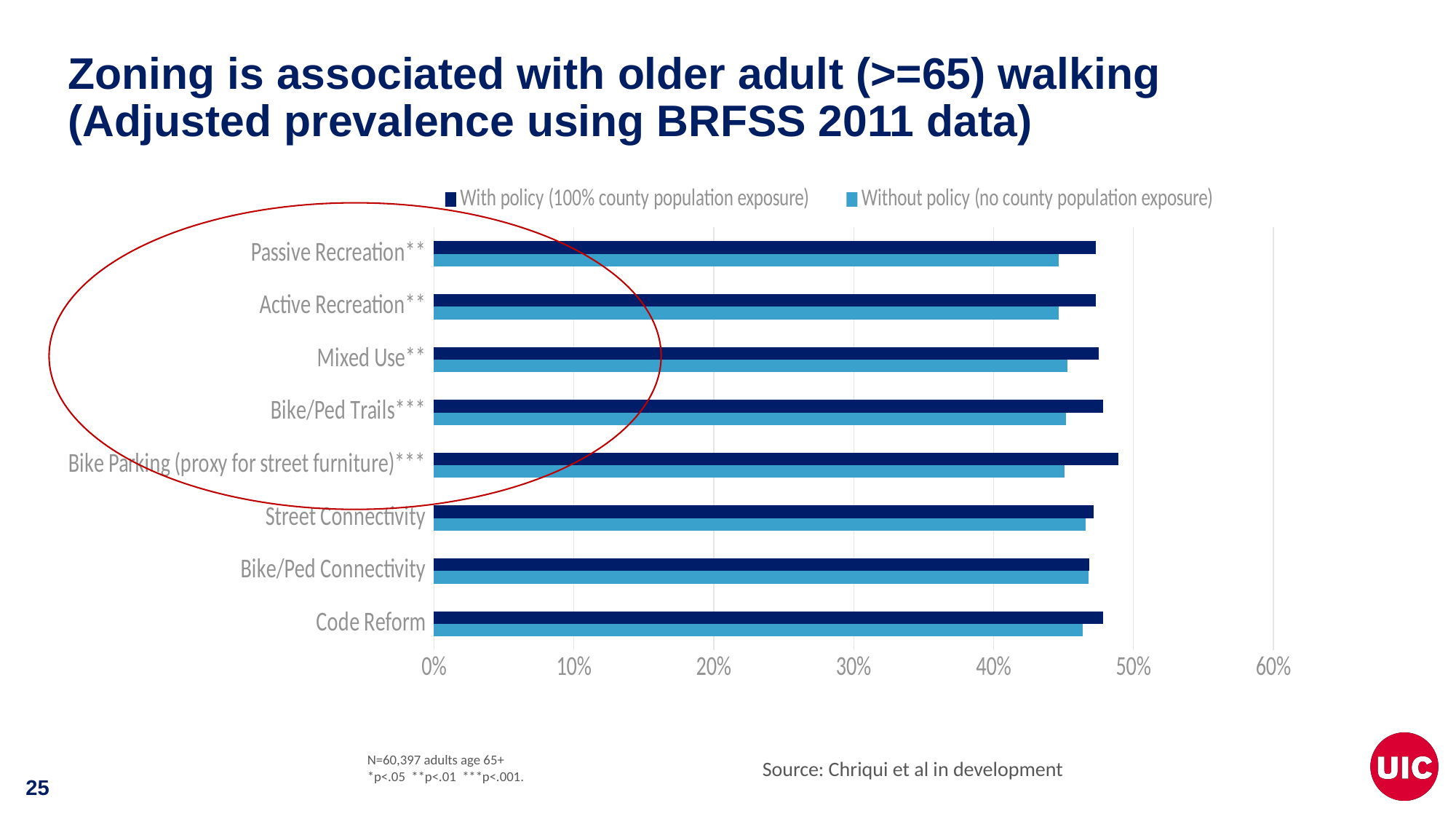
What is the highest value shown on the horizontal axis of the chart? 60% Is the 'With policy' value for Bike Parking (proxy for street furniture) greater or less than 50%? less How many series does the chart's legend list? 2 Is the 'Without policy' value for Mixed Use greater or less than 50%? less What kind of chart is shown on the slide? bar chart For Passive Recreation, which is larger: the 'With policy' value or the 'Without policy' value? With policy What does the dark blue series in the legend represent? With policy (100% county population exposure) For Bike Parking (proxy for street furniture), which is larger: the 'With policy' value or the 'Without policy' value? With policy Which category has the highest 'With policy' value? Bike Parking (proxy for street furniture) Is the 'With policy' value for Code Reform greater or less than 40%? greater How many zoning categories are listed on the vertical axis of the chart? 8